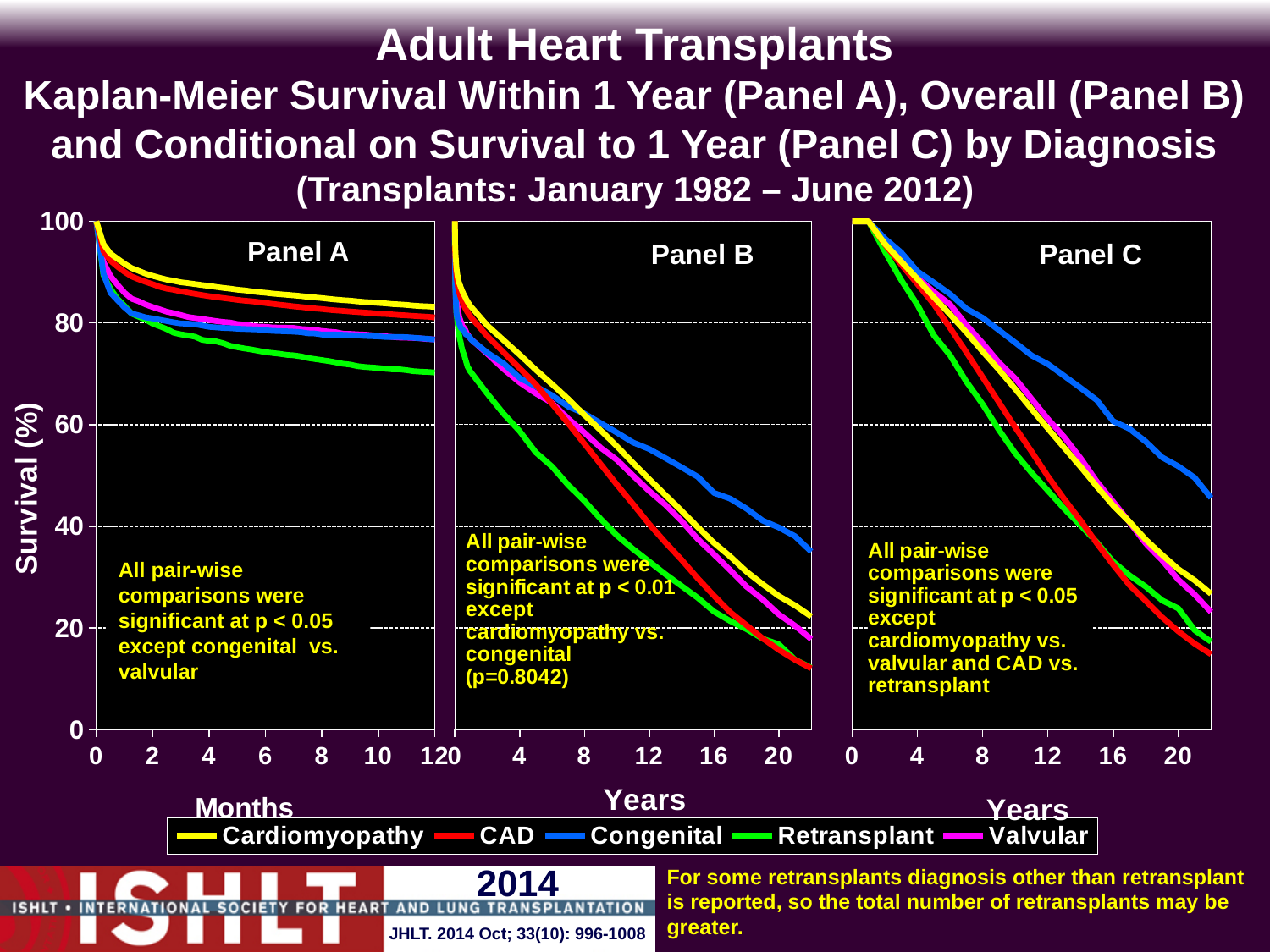
In Panel B, do the survival curves rise or fall as years increase? Fall In Panel B, which diagnosis has the highest survival at 20 years? Congenital In Panel B, is the survival for Congenital at 20 years greater or less than 20? greater In Panel B, is the survival for Retransplant at 8 years greater or less than 60? less What colour represents Congenital in the legend? Blue How many series does the legend list? 5 In Panel C, is the survival for CAD at 20 years greater or less than 40? less In Panel A, which diagnosis has the highest survival at 12 months? Cardiomyopathy In Panel A, which diagnosis has the lowest survival at 12 months? Retransplant What kind of chart is shown in Panel A? Line chart In Panel C, which diagnosis has the highest survival at 20 years? Congenital